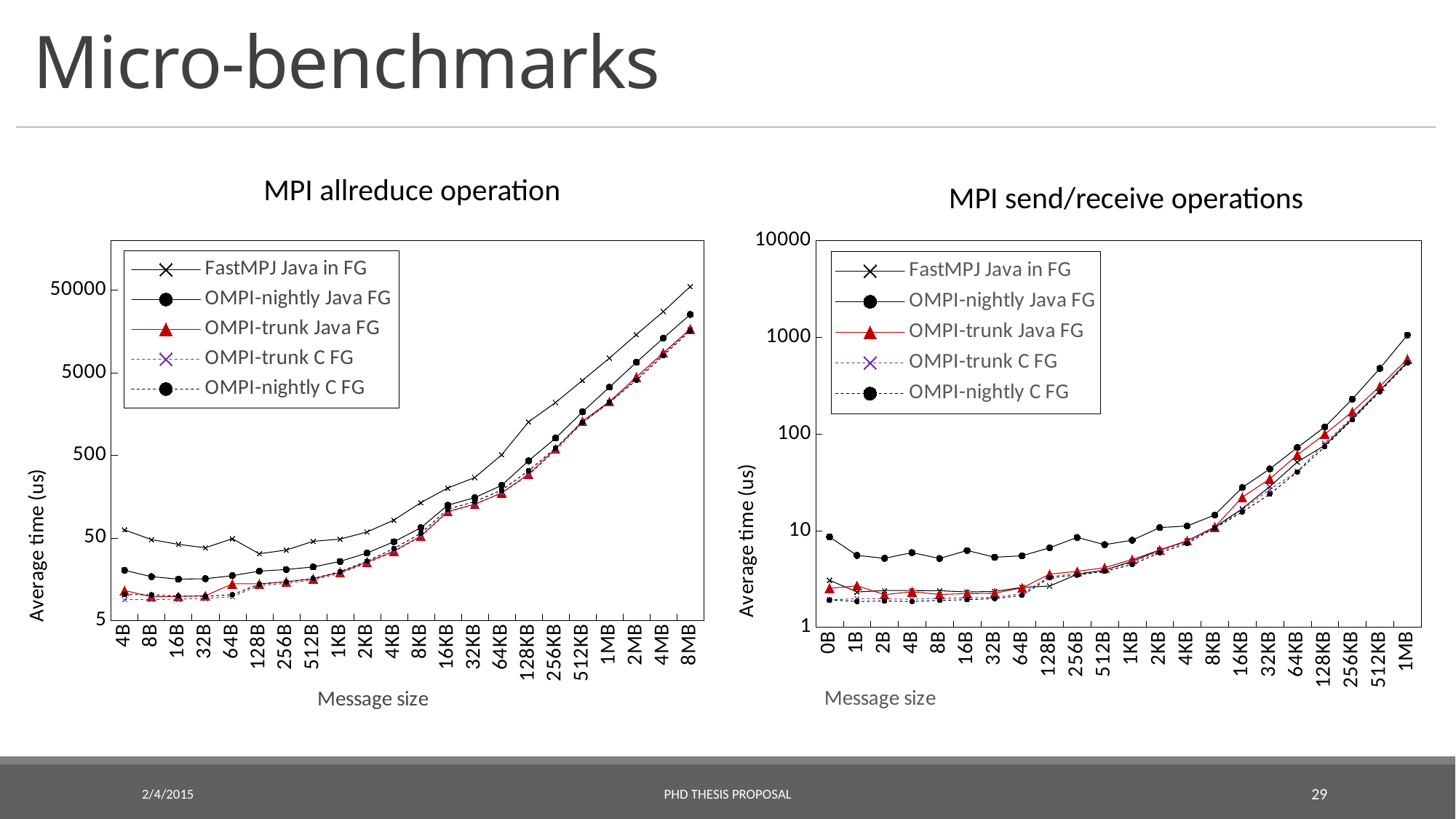
How many message sizes are plotted along the x axis of the 'MPI allreduce operation' chart? 22 In the 'MPI send/receive operations' chart, is the value for FastMPJ Java in FG at 1MB greater or less than 1000? less How many message sizes are plotted along the x axis of the 'MPI send/receive operations' chart? 22 In the 'MPI allreduce operation' chart, is the value for FastMPJ Java in FG at 4B greater or less than 50? greater In the 'MPI allreduce operation' chart, which series has the highest average time at 4B? FastMPJ Java in FG How many series does the legend of the 'MPI send/receive operations' chart list? 5 What is the y-axis label of the 'MPI allreduce operation' chart? Average time (us) In the 'MPI send/receive operations' chart, which series has the highest average time at 0B? OMPI-nightly Java FG What kind of chart is the 'MPI allreduce operation' chart? line chart In the 'MPI allreduce operation' chart, is the value for OMPI-nightly Java FG at 4B greater or less than 50? less In the 'MPI send/receive operations' chart, do the average times generally rise or fall as message size increases from 8KB to 1MB? rise In the 'MPI allreduce operation' chart, which is larger at 8MB: FastMPJ Java in FG or OMPI-nightly Java FG? FastMPJ Java in FG